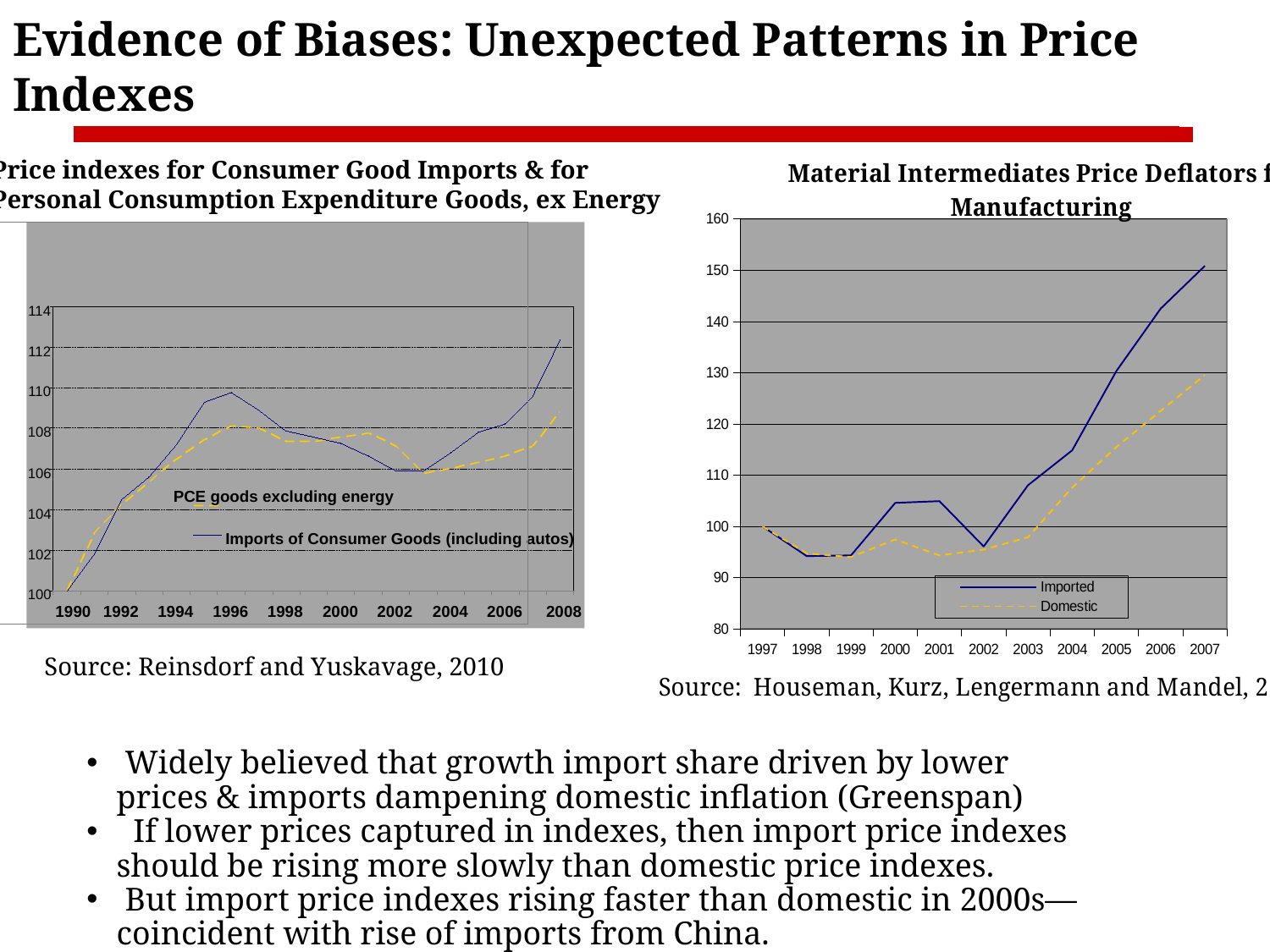
In the left-hand chart (Price indexes for Consumer Good Imports & for Personal Consumption Expenditure Goods, ex Energy), which series is higher in 2008, PCE goods excluding energy or Imports of Consumer Goods (including autos)? Imports of Consumer Goods (including autos) In the right-hand chart (Material Intermediates Price Deflators for Manufacturing), which series is higher in 2007, Imported or Domestic? Imported How many years are labeled on the x axis of the right-hand chart (Material Intermediates Price Deflators for Manufacturing)? 11 In the right-hand chart (Material Intermediates Price Deflators for Manufacturing), is the Imported value in 2007 greater or less than 140? greater In the right-hand chart (Material Intermediates Price Deflators for Manufacturing), is the Imported value in 2002 greater or less than 100? less In the right-hand chart (Material Intermediates Price Deflators for Manufacturing), does the Imported series rise or fall from 2002 to 2007? rise What kind of chart is the 'Material Intermediates Price Deflators for Manufacturing' chart on the right? line chart In the left-hand chart (Price indexes for Consumer Good Imports & for Personal Consumption Expenditure Goods, ex Energy), is the value of Imports of Consumer Goods (including autos) in 2008 greater or less than 110? greater In the left-hand chart (Price indexes for Consumer Good Imports & for Personal Consumption Expenditure Goods, ex Energy), which series is drawn as a dashed line? PCE goods excluding energy How many series does the legend of the right-hand chart (Material Intermediates Price Deflators for Manufacturing) list? 2 In the right-hand chart (Material Intermediates Price Deflators for Manufacturing), what is the value of the Imported series in 1997? 100